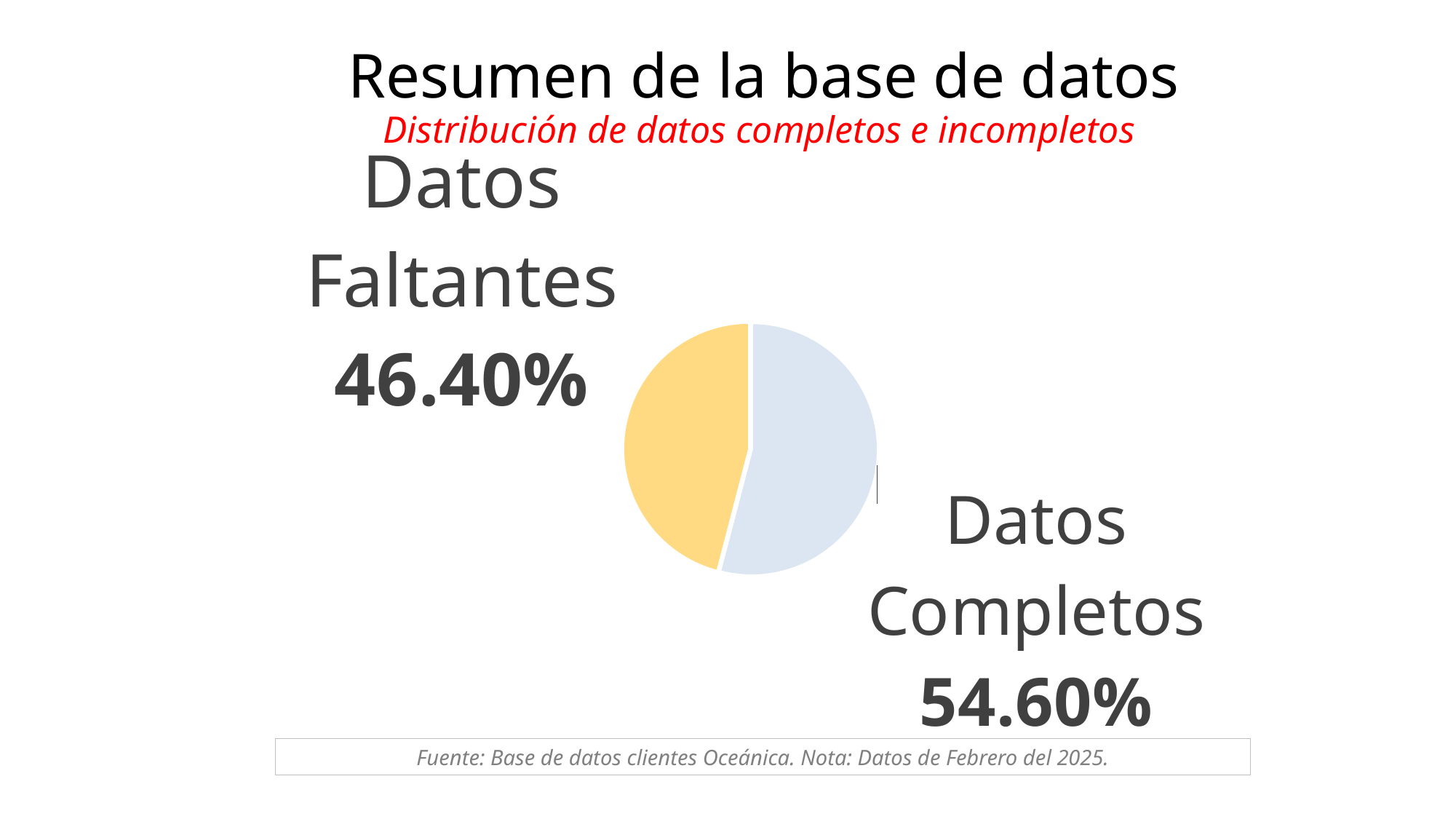
What share of the pie does Datos Completos represent? 54.60% Which slice of the pie chart is the largest? Datos Completos Which slice of the pie chart is the smallest? Datos Faltantes What percentage of the pie chart is labelled Datos Faltantes? 46.40% What kind of chart is shown on the slide? Pie chart Which is larger, Datos Faltantes or Datos Completos? Datos Completos How many slices does the pie chart have? 2 What is the difference in percentage points between Datos Completos and Datos Faltantes? 8.20 What is the subtitle of the chart shown in red? Distribución de datos completos e incompletos What colour is the Datos Faltantes slice of the pie chart? Yellow What percentage of the pie chart is labelled Datos Completos? 54.60%